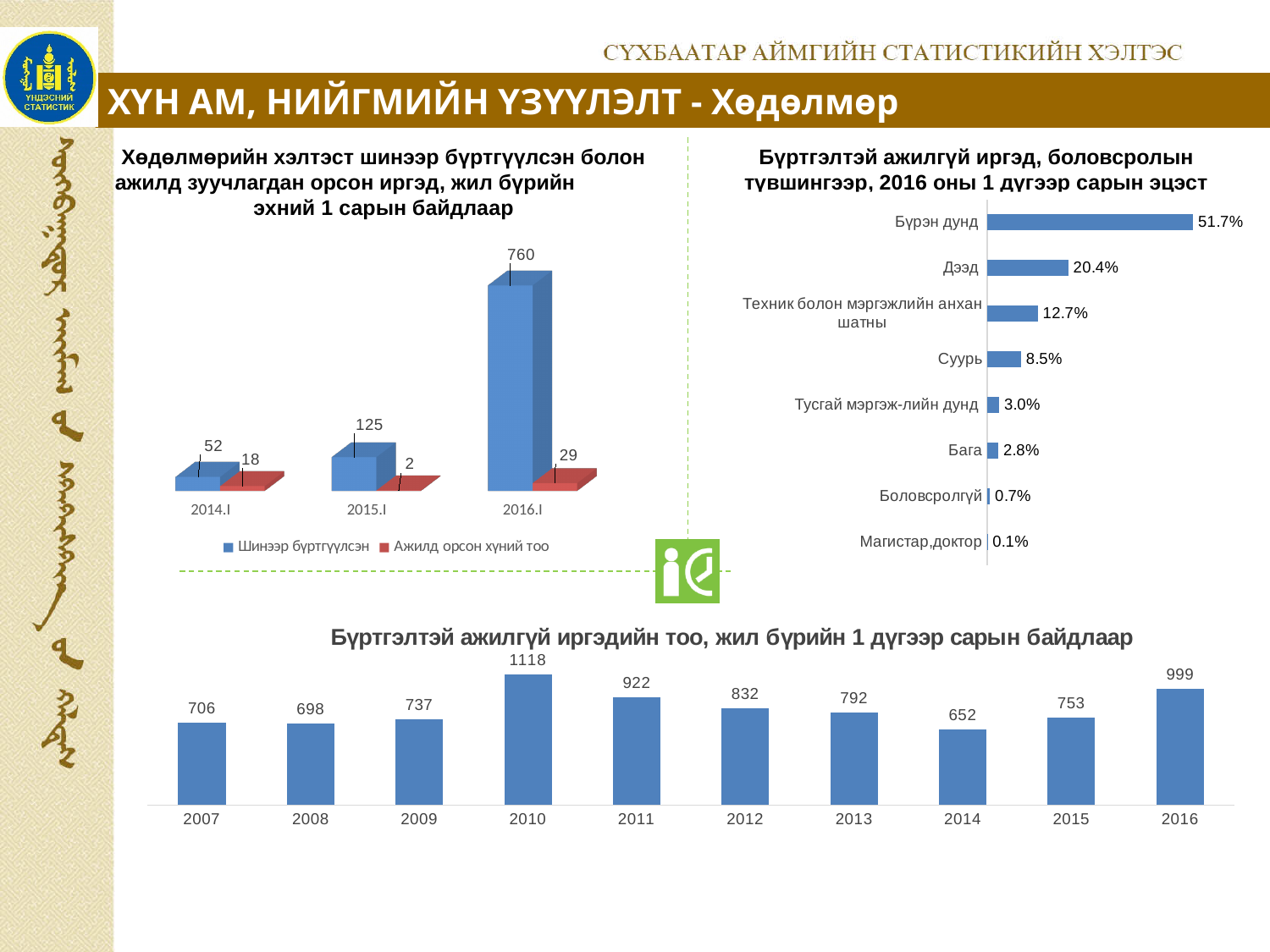
In the top-right chart (Бүртгэлтэй ажилгүй иргэд, боловсролын түвшингээр), which category has the highest value? Бүрэн дунд In the bottom chart (Бүртгэлтэй ажилгүй иргэдийн тоо), how many years are shown on the x axis? 10 In the bottom chart (Бүртгэлтэй ажилгүй иргэдийн тоо), which is larger, the value for 2011 or the value for 2012? 2011 In the top-left chart (Хөдөлмөрийн хэлтэст шинээр бүртгүүлсэн болон ажилд зуучлагдан орсон иргэд), what is the value of Ажилд орсон хүний тоо for 2015.I? 2 What kind of chart is the top-right chart (Бүртгэлтэй ажилгүй иргэд, боловсролын түвшингээр)? Bar chart In the top-right chart (Бүртгэлтэй ажилгүй иргэд, боловсролын түвшингээр), how many categories are shown? 8 In the bottom chart (Бүртгэлтэй ажилгүй иргэдийн тоо), what is the difference between the values for 2016 and 2015? 246 In the top-left chart (Хөдөлмөрийн хэлтэст шинээр бүртгүүлсэн болон ажилд зуучлагдан орсон иргэд), what is the value of Шинээр бүртгүүлсэн for 2016.I? 760 In the top-left chart (Хөдөлмөрийн хэлтэст шинээр бүртгүүлсэн болон ажилд зуучлагдан орсон иргэд), how many series does the legend list? 2 In the bottom chart (Бүртгэлтэй ажилгүй иргэдийн тоо, жил бүрийн 1 дүгээр сарын байдлаар), what is the value for 2010? 1118 In the bottom chart (Бүртгэлтэй ажилгүй иргэдийн тоо), which year has the lowest value? 2014 In the top-right chart (Бүртгэлтэй ажилгүй иргэд, боловсролын түвшингээр), what is the value for Дээд? 20.4%